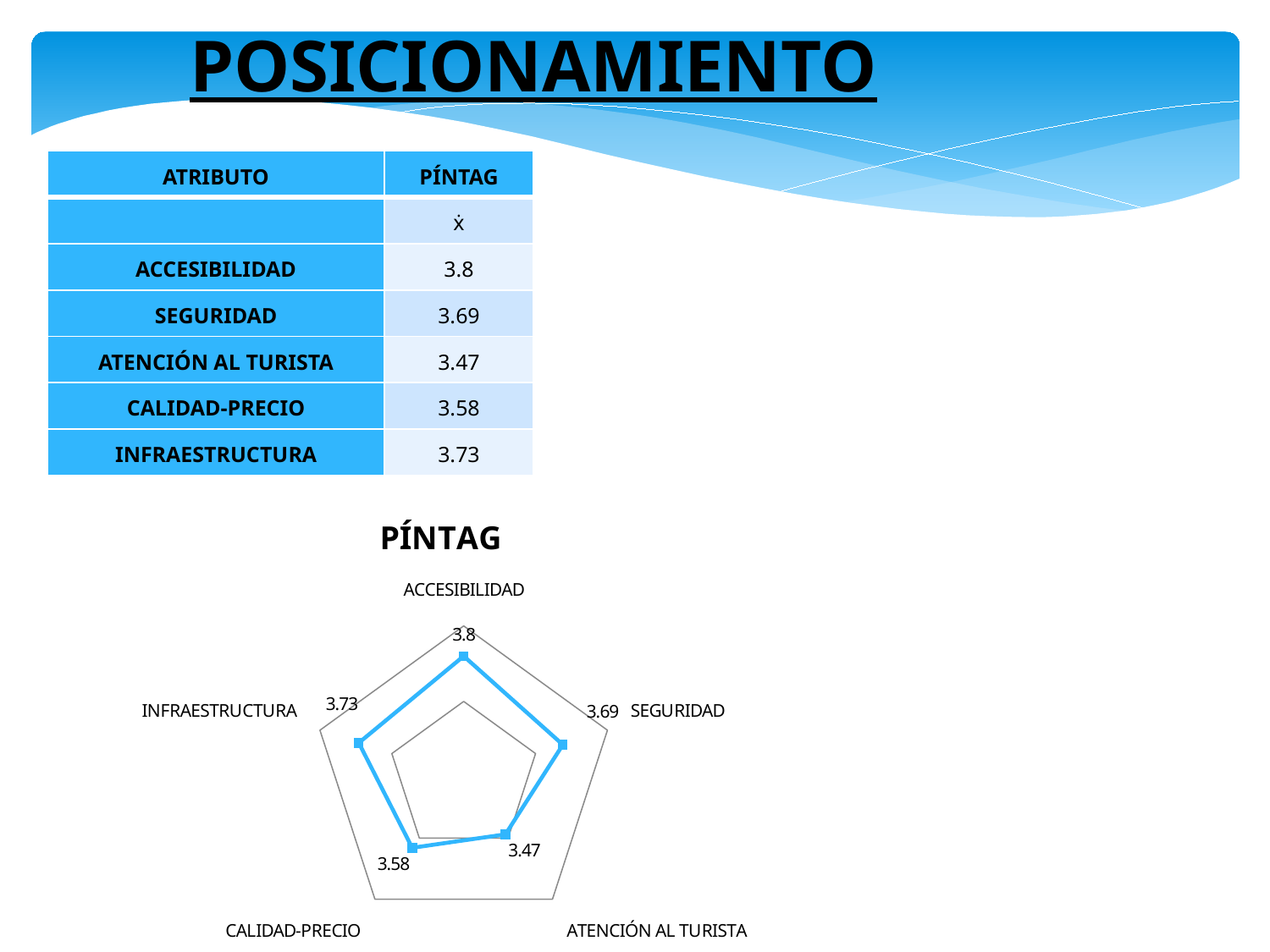
What is the value for ACCESIBILIDAD in the PÍNTAG chart? 3.8 What is the title of the chart on the slide? PÍNTAG What is the value for SEGURIDAD in the PÍNTAG chart? 3.69 What is the value for INFRAESTRUCTURA in the PÍNTAG chart? 3.73 What type of chart is shown under the title PÍNTAG? Radar chart Which attribute has the lowest value in the PÍNTAG chart? ATENCIÓN AL TURISTA What is the value for ATENCIÓN AL TURISTA in the PÍNTAG chart? 3.47 What is the value for CALIDAD-PRECIO in the PÍNTAG chart? 3.58 In the PÍNTAG chart, which is larger: the value for INFRAESTRUCTURA or the value for CALIDAD-PRECIO? INFRAESTRUCTURA Which attribute has the highest value in the PÍNTAG chart? ACCESIBILIDAD How many attributes are plotted in the PÍNTAG chart? 5 What is the difference between the values for ACCESIBILIDAD and ATENCIÓN AL TURISTA in the PÍNTAG chart? 0.33